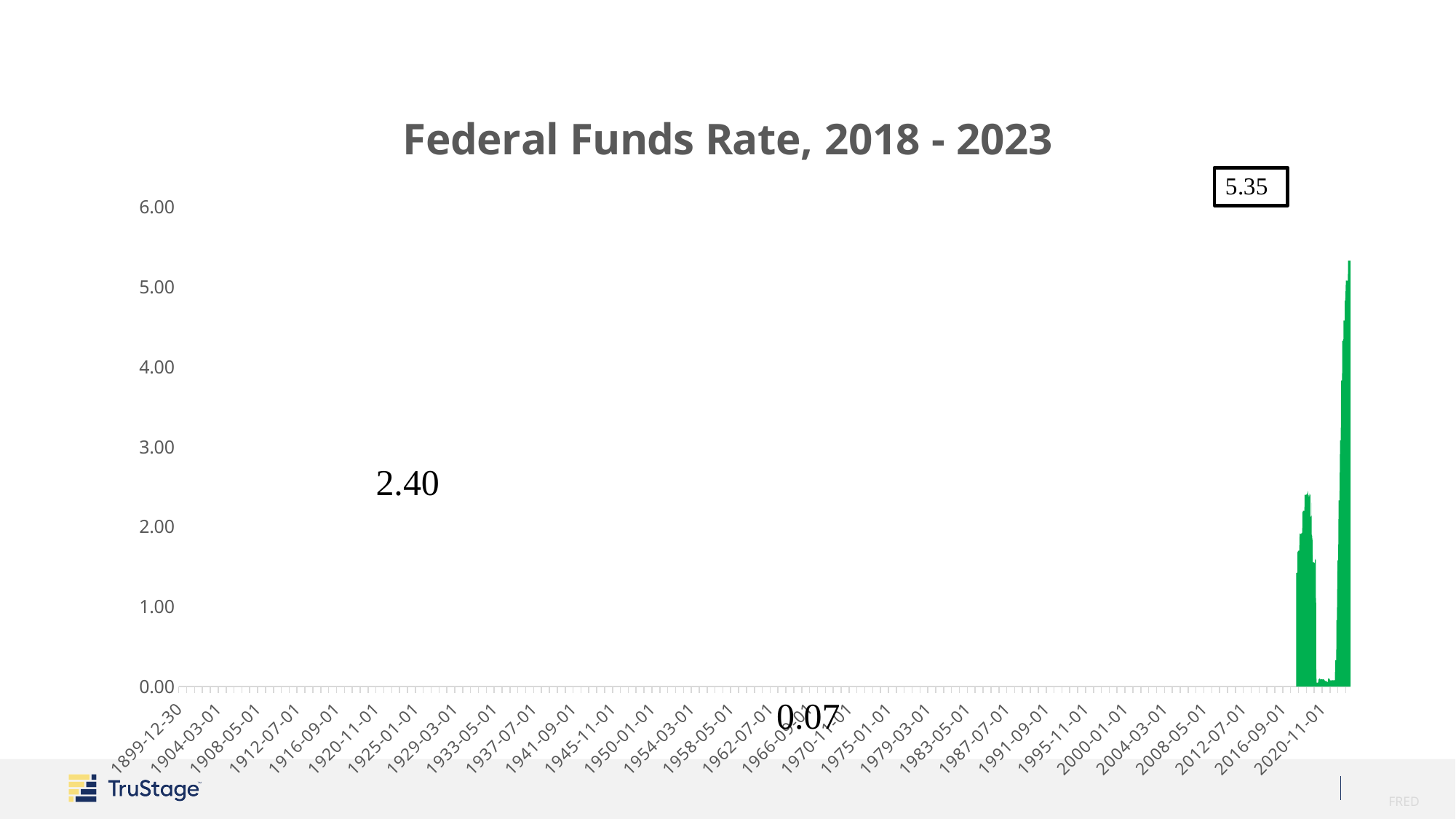
What is the difference between the labelled values 5.35 and 2.40? 2.95 How many data values are labelled on the chart? 3 What value is shown in the boxed label near the top right of the chart? 5.35 Which labelled value is larger, 5.35 or 2.40? 5.35 What is the highest value labelled on the chart? 5.35 What is the difference between the labelled values 5.35 and 0.07? 5.28 What colour is the plotted data on the chart? Green What is the title of the chart? Federal Funds Rate, 2018 - 2023 Is the highest point of the Federal Funds Rate greater or less than 5.00? greater Is the earlier peak of the Federal Funds Rate greater or less than 3.00? less What is the lowest value labelled on the chart? 0.07 What value is labelled for the earlier peak of the Federal Funds Rate on the chart? 2.40